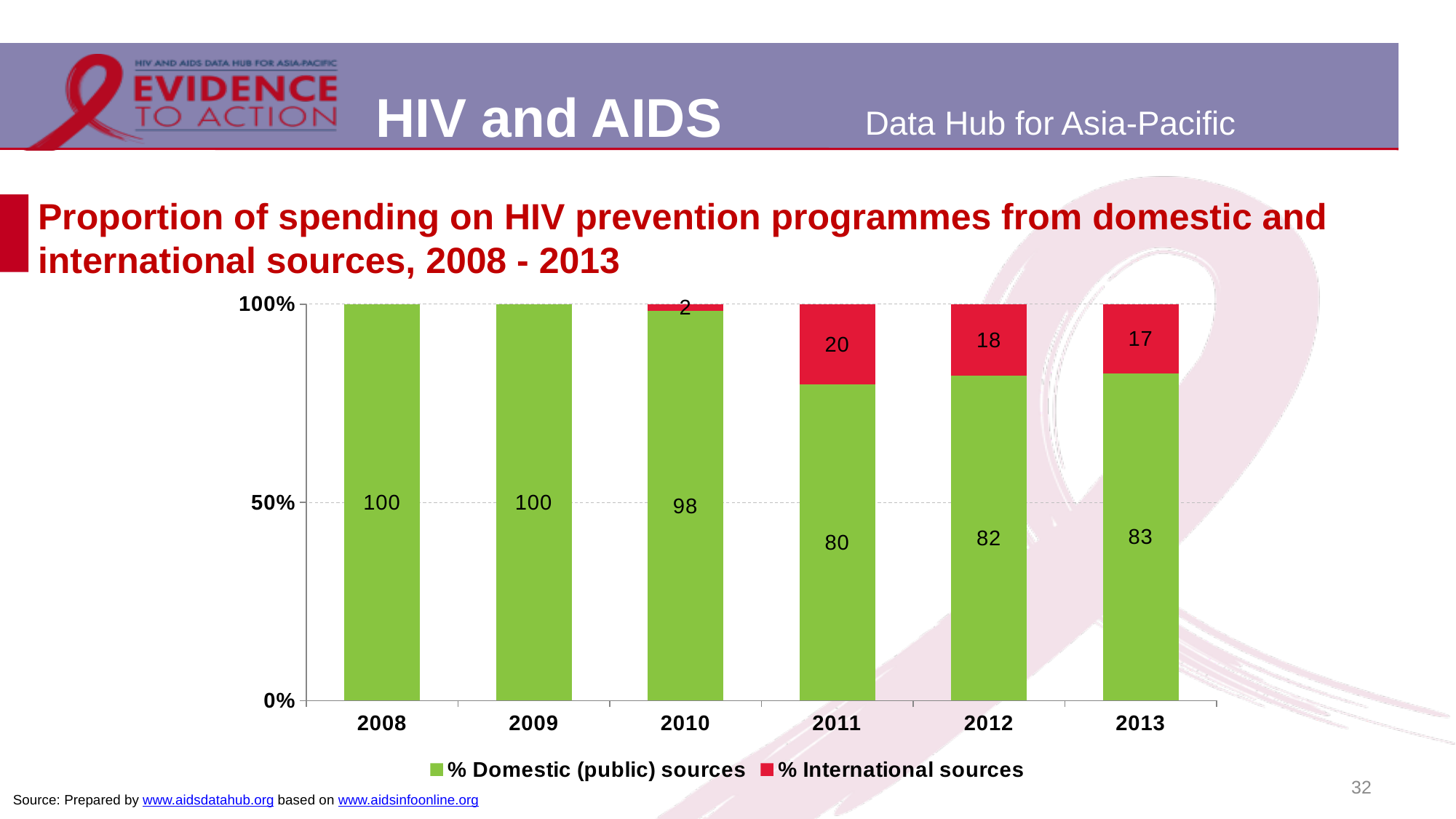
Which year has the highest value for % International sources? 2011 Which year has the lowest value for % Domestic (public) sources? 2011 Does the % Domestic (public) sources value rise or fall from 2011 to 2013? Rise What is the difference between the % Domestic (public) sources values for 2008 and 2012? 18 What is the value for % International sources in 2010? 2 What is the value for % Domestic (public) sources in 2011? 80 What kind of chart is shown on the slide? Stacked bar chart How many series does the legend list? 2 What is the value for % International sources in 2013? 17 What colour represents % International sources in the chart? Red Which is larger, the % International sources value for 2012 or for 2013? 2012 How many years are shown on the x axis? 6